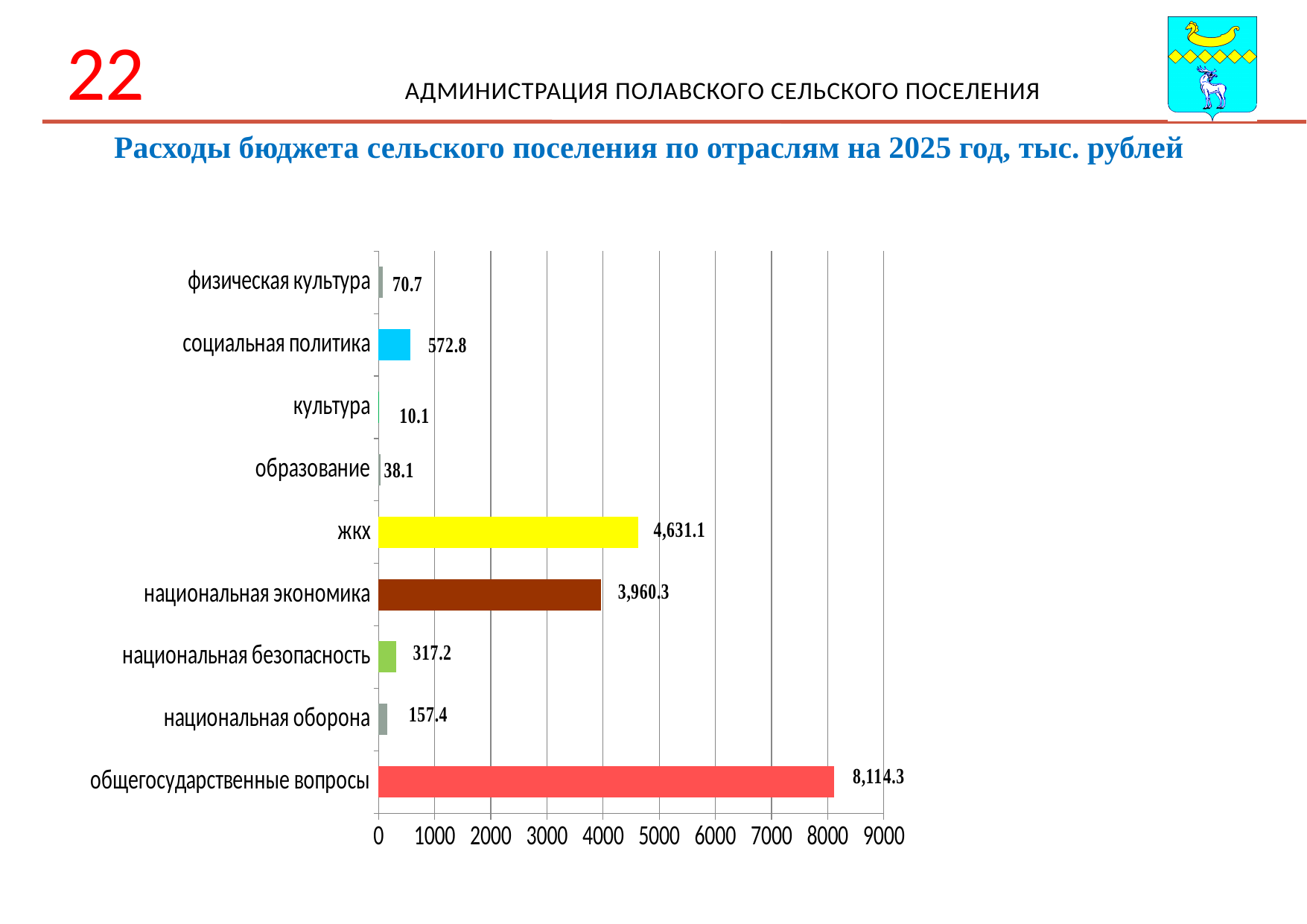
What is the difference between the values for жкх and национальная экономика? 670.8 Which category has the lowest value? культура How many categories are shown in the chart? 9 What kind of chart is shown on the slide? bar chart What is the difference between the values for общегосударственные вопросы and жкх? 3,483.2 What is the value for образование? 38.1 Which is larger, the value for социальная политика or the value for национальная безопасность? социальная политика Is the value for национальная экономика greater or less than 4000? less What is the value for национальная оборона? 157.4 What is the value for жкх? 4,631.1 Which category has the highest value? общегосударственные вопросы What is the value for социальная политика? 572.8